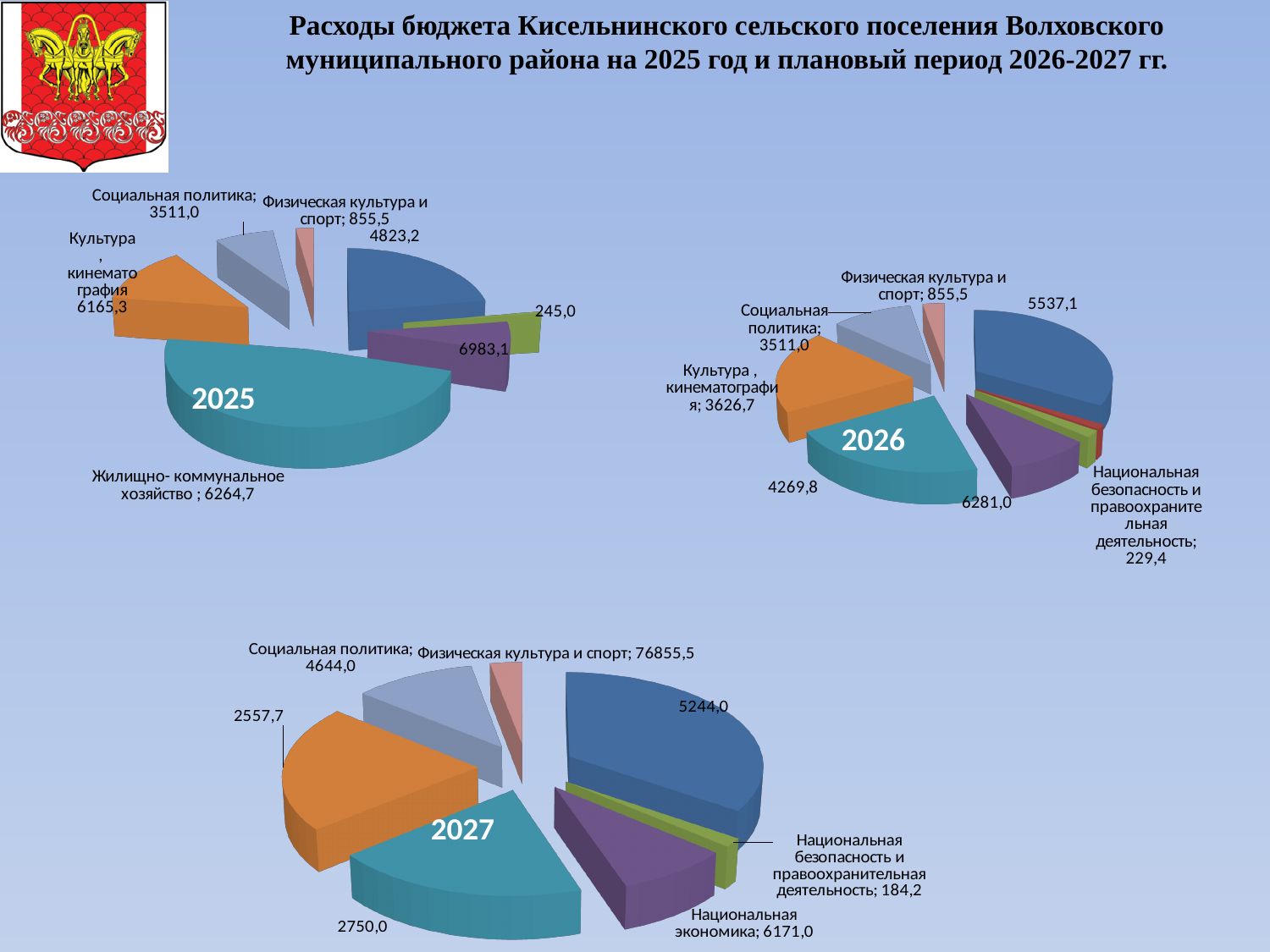
On the 2026 chart, which category has the smallest value? Национальная безопасность и правоохранительная деятельность What kind of chart is used for the 2025 budget expenditures? Pie chart On the 2027 chart, what is the value for Национальная экономика? 6171,0 On the 2026 chart, what is the difference between Социальная политика and Физическая культура и спорт? 2655,5 On the 2025 chart, what is the value for Жилищно-коммунальное хозяйство? 6264,7 On the 2025 chart, what is the value for Культура, кинематография? 6165,3 On the 2026 chart, what is the value for Культура, кинематография? 3626,7 On the 2027 chart, what is the value for Национальная безопасность и правоохранительная деятельность? 184,2 On the 2025 chart, how many slices does the pie have? 7 On the 2025 chart, what is the smallest value shown? 245,0 On the 2027 chart, what is the difference between Социальная политика and Национальная безопасность и правоохранительная деятельность? 4459,8 On the 2025 chart, which is larger: Жилищно-коммунальное хозяйство or Социальная политика? Жилищно-коммунальное хозяйство